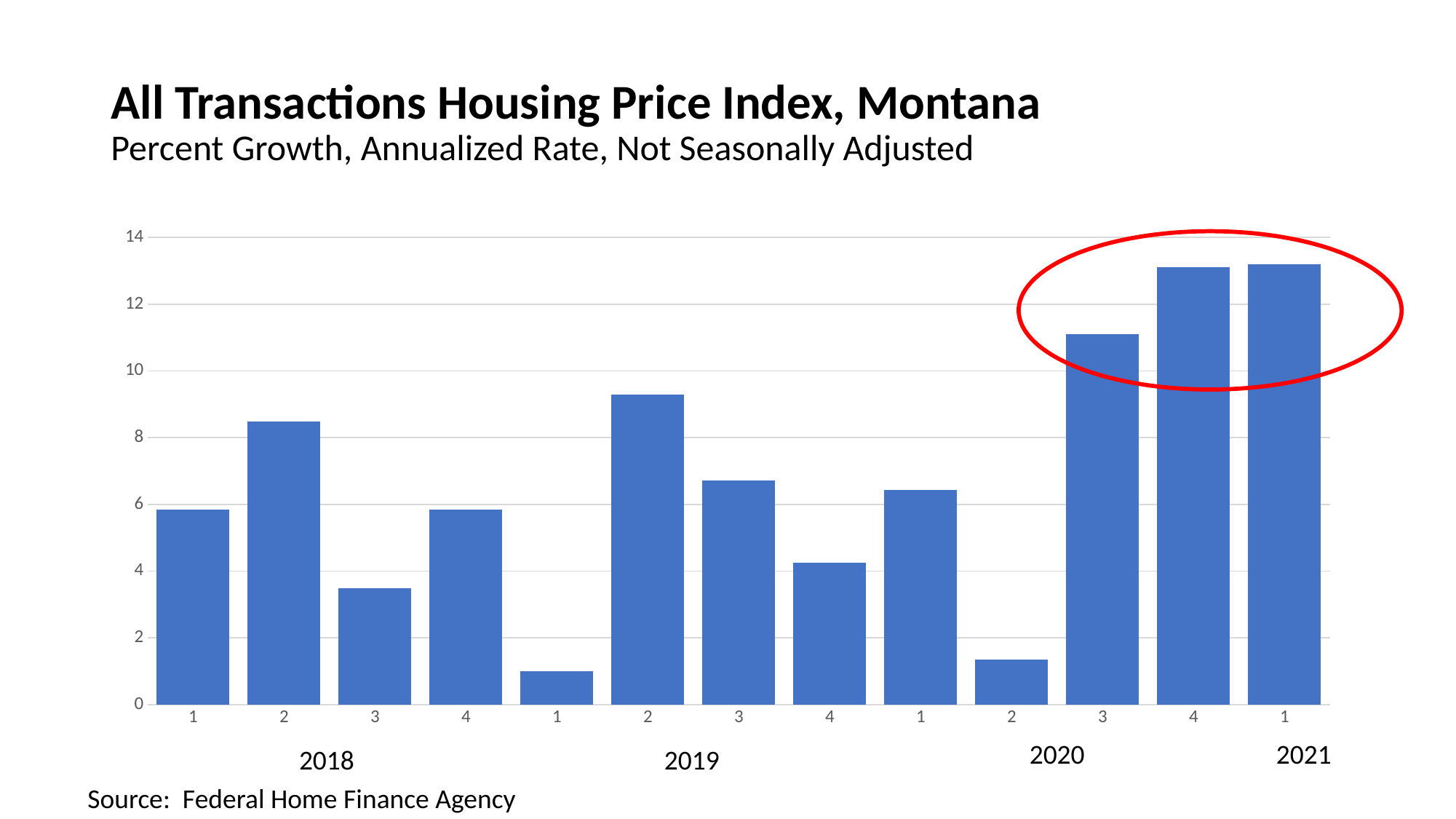
Is the value for quarter 3 of 2020 greater or less than 10? greater How many bars (quarters) are plotted in the chart? 13 Which is larger, the value for quarter 2 of 2018 or quarter 3 of 2018? quarter 2 of 2018 Which is larger, the value for quarter 2 of 2019 or quarter 4 of 2019? quarter 2 of 2019 What is the title of the chart? All Transactions Housing Price Index, Montana Is the value for quarter 4 of 2020 greater or less than 12? greater What source is cited for the chart data? Federal Home Finance Agency Is the value for quarter 2 of 2019 greater or less than 8? greater Do the values rise or fall from quarter 2 of 2020 to quarter 1 of 2021? rise What kind of chart is shown on the slide? bar chart